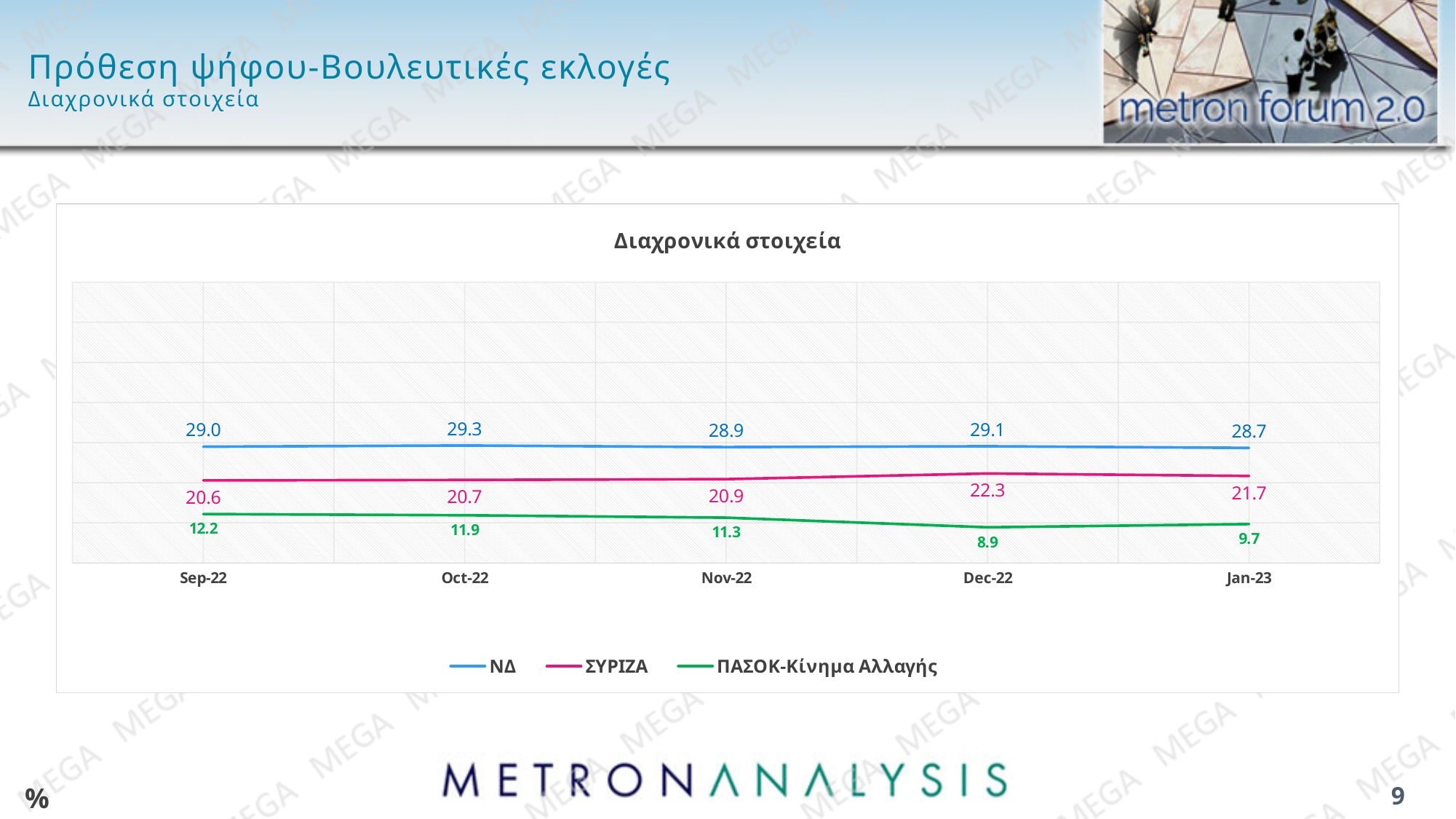
What is the value for ΣΥΡΙΖΑ in Dec-22? 22.3 Does the ΠΑΣΟΚ-Κίνημα Αλλαγής value rise or fall from Sep-22 to Nov-22? Fall What is the title of the chart? Διαχρονικά στοιχεία Which is larger, the ΣΥΡΙΖΑ value in Dec-22 or in Jan-23? Dec-22 How many time points are shown on the x axis? 5 What is the value for ΠΑΣΟΚ-Κίνημα Αλλαγής in Nov-22? 11.3 What is the value for ΝΔ in Oct-22? 29.3 What is the difference between the ΝΔ and ΣΥΡΙΖΑ values in Jan-23? 7.0 In which month does ΝΔ have its highest value? Oct-22 In which month does ΠΑΣΟΚ-Κίνημα Αλλαγής have its lowest value? Dec-22 How many series does the legend list? 3 What kind of chart is shown on the slide? Line chart